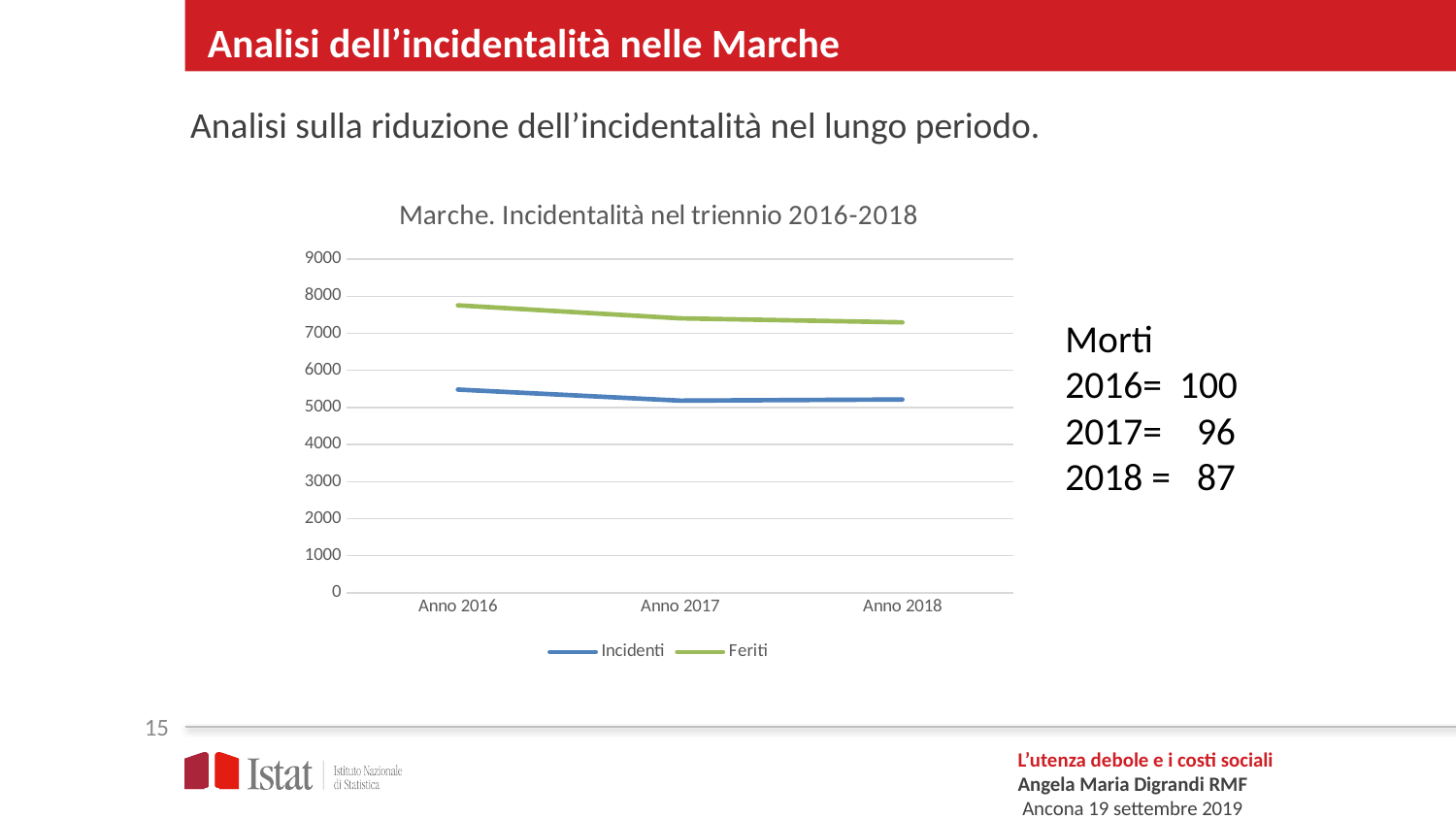
What is the title of the chart? Marche. Incidentalità nel triennio 2016-2018 In which year is the Feriti series at its highest? Anno 2016 In Anno 2017, which series has the larger value, Incidenti or Feriti? Feriti Which series are listed in the chart legend? Incidenti, Feriti Is the value for Incidenti in Anno 2016 greater or less than 5000? greater Is the value for Feriti in Anno 2018 greater or less than 8000? less Is the value for Feriti in Anno 2016 greater or less than 7000? greater What kind of chart is shown on the slide? line chart How many years are plotted along the x axis of the chart? 3 How many series does the chart legend list? 2 Does the Feriti series rise or fall from Anno 2016 to Anno 2018? fall